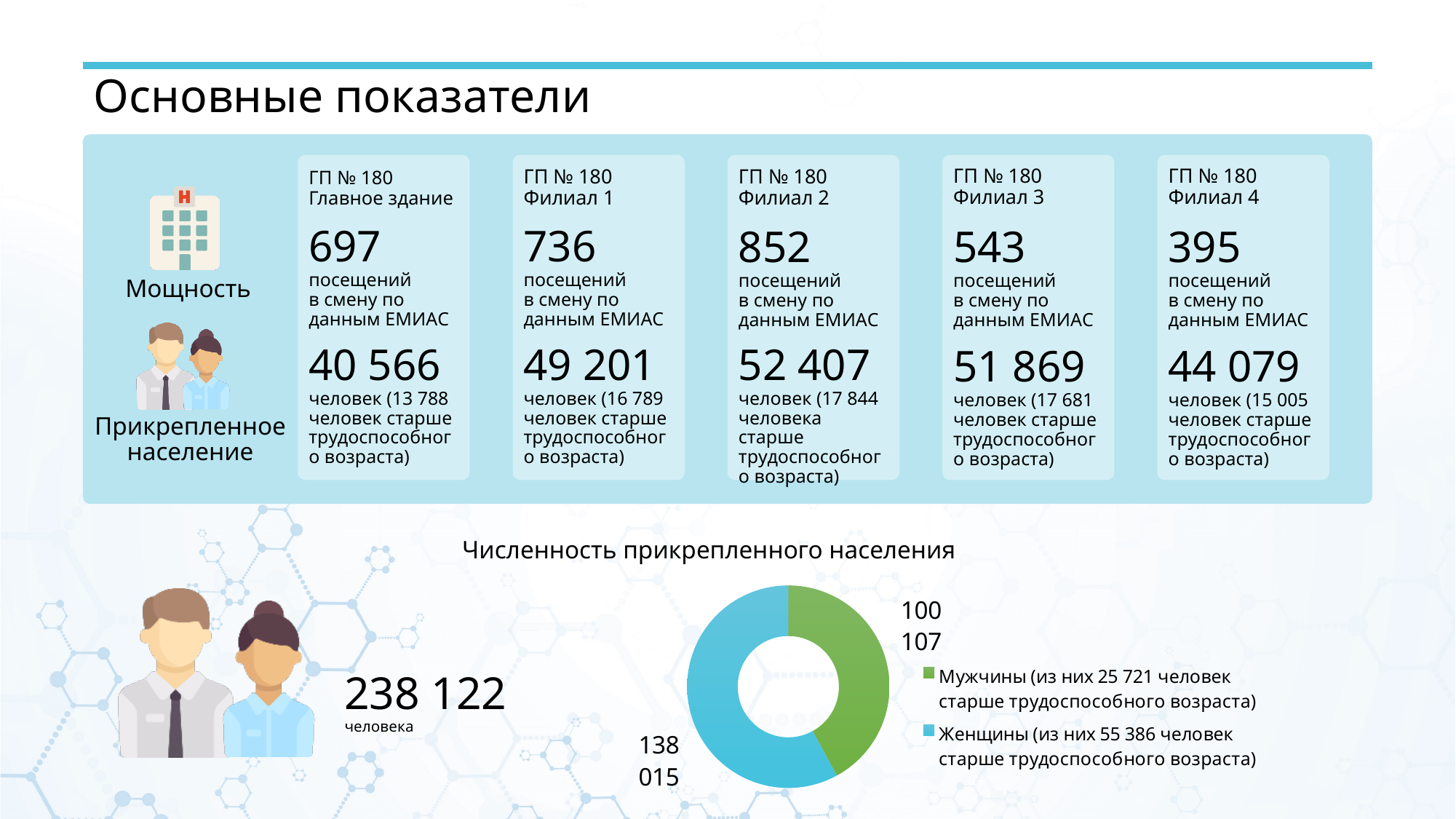
In the chart "Численность прикрепленного населения", which category has the smallest slice? Мужчины In the chart "Численность прикрепленного населения", which category has the largest slice? Женщины In the chart "Численность прикрепленного населения", what share of the total does Женщины represent, to the nearest whole percent? 58% In the chart "Численность прикрепленного населения", what is the value for Мужчины? 100 107 In the chart "Численность прикрепленного населения", what is the value for Женщины? 138 015 How many slices does the chart "Численность прикрепленного населения" have? 2 In the chart "Численность прикрепленного населения", what is the difference between the values for Женщины and Мужчины? 37 908 What kind of chart is "Численность прикрепленного населения"? Doughnut (pie) chart In the chart "Численность прикрепленного населения", what colour is the Мужчины slice? Green In the chart "Численность прикрепленного населения", which is larger: Мужчины or Женщины? Женщины How many entries does the legend of the chart "Численность прикрепленного населения" list? 2 In the chart "Численность прикрепленного населения", what is the total of the two slices? 238 122